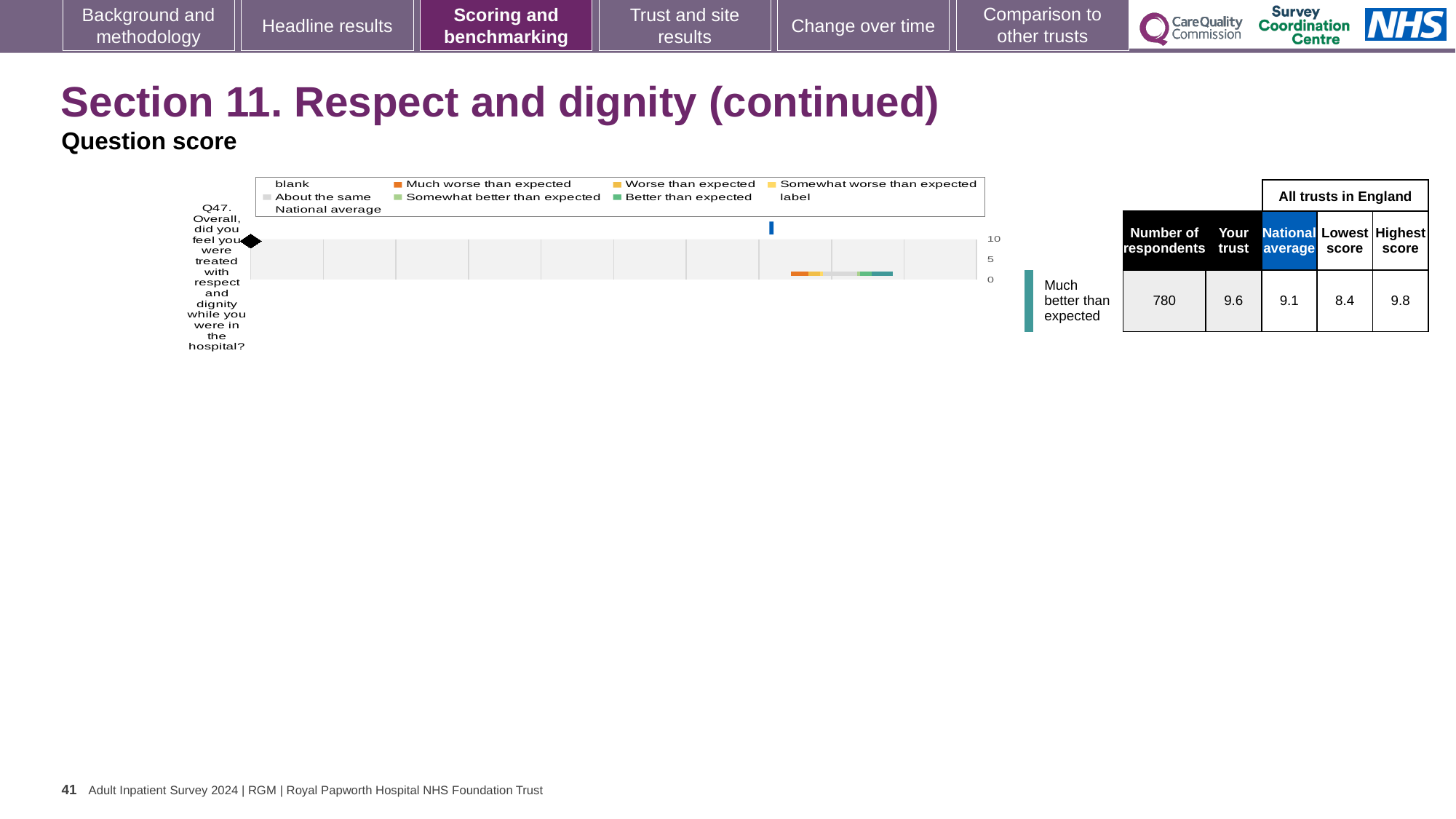
What is the national average score for Q47 shown on the slide? 9.1 Which is larger for Q47: the trust's score or the national average? Your trust What is the 'Your trust' score for Q47 on the respect and dignity chart? 9.6 What benchmarking category is the trust's Q47 result placed in? Much better than expected Is the trust's Q47 score greater or less than 5 on the chart's axis? greater How many respondents answered Q47? 780 What is the highest score among all trusts in England for Q47? 9.8 By how much does the trust's Q47 score exceed the national average? 0.5 What is the highest tick value shown on the chart's score axis? 10 What kind of chart is used to show the Q47 question score? bar chart What is the difference between the highest and lowest trust scores for Q47? 1.4 What is the lowest score among all trusts in England for Q47? 8.4